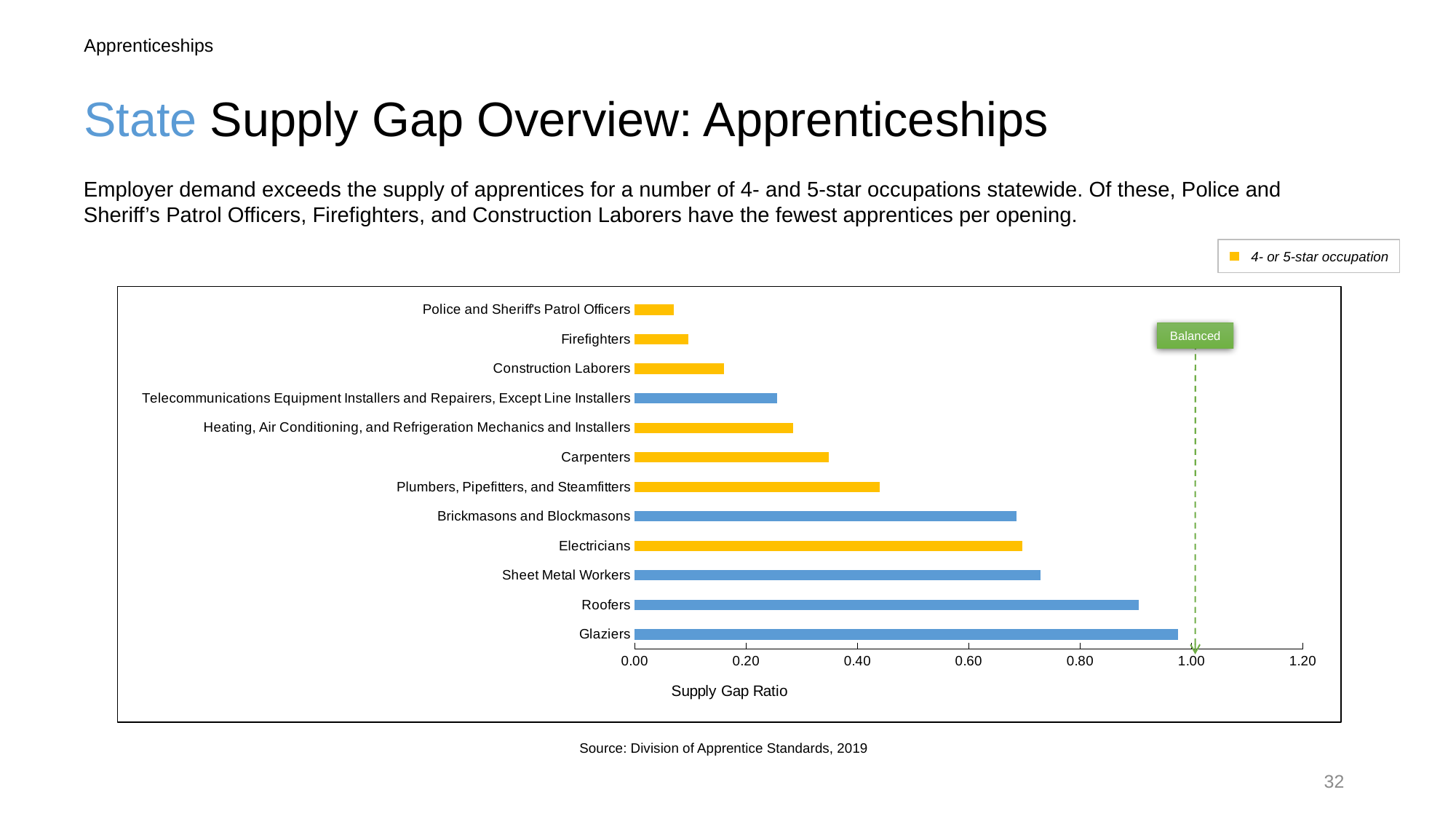
How many occupations are plotted in the chart? 12 What is the title of the x axis? Supply Gap Ratio Which occupation has the highest supply gap ratio? Glaziers Which occupation has the lowest supply gap ratio? Police and Sheriff's Patrol Officers What kind of chart is shown on the slide? Bar chart Is the supply gap ratio for Roofers greater or less than 0.80? greater At what x-axis value is the dashed 'Balanced' line drawn? 1.00 How many entries does the legend list? 1 Is the supply gap ratio for Glaziers greater or less than 1.00? less Is the supply gap ratio for Construction Laborers greater or less than 0.20? less Which has a larger supply gap ratio, Carpenters or Plumbers, Pipefitters, and Steamfitters? Plumbers, Pipefitters, and Steamfitters Which has a larger supply gap ratio, Roofers or Sheet Metal Workers? Roofers